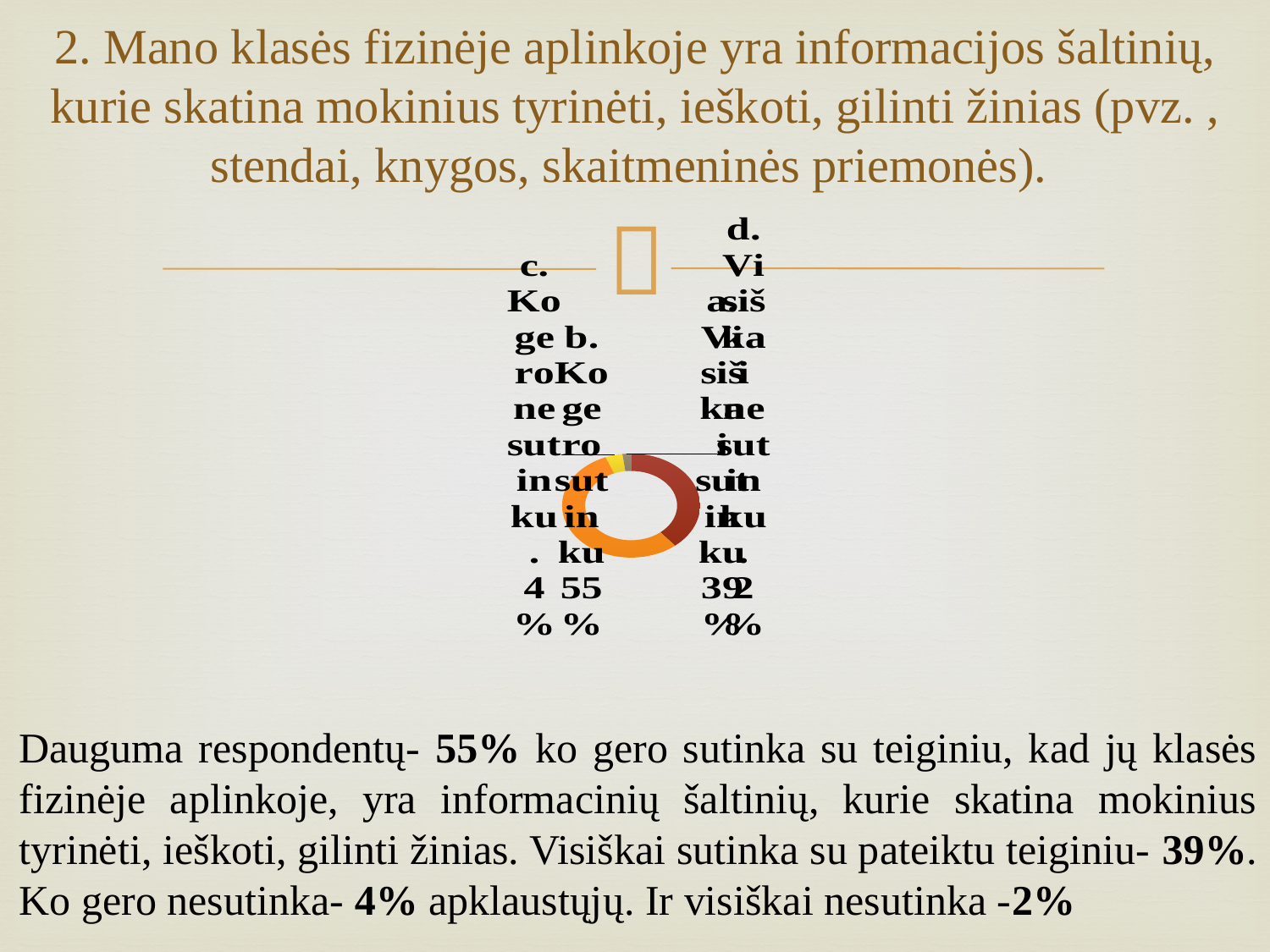
Which response option has the largest share in the chart? Ko gero sutinku (55%) What percentage of respondents answered 'Ko gero sutinku'? 55% How many slices does the doughnut chart have? 4 What percentage of respondents answered 'Visiškai sutinku'? 39% Which is larger: the share for 'Ko gero nesutinku' or the share for 'Visiškai nesutinku'? Ko gero nesutinku What is the combined share of the two agreeing responses ('Visiškai sutinku' and 'Ko gero sutinku')? 94% What percentage of respondents answered 'Visiškai nesutinku'? 2% What is the difference between the 'Ko gero sutinku' share and the 'Visiškai sutinku' share? 16% Which response option has the smallest share in the chart? Visiškai nesutinku (2%) What percentage of respondents answered 'Ko gero nesutinku'? 4% Is the share for 'Ko gero sutinku' greater or less than 50%? greater What kind of chart is shown on the slide? doughnut (pie) chart